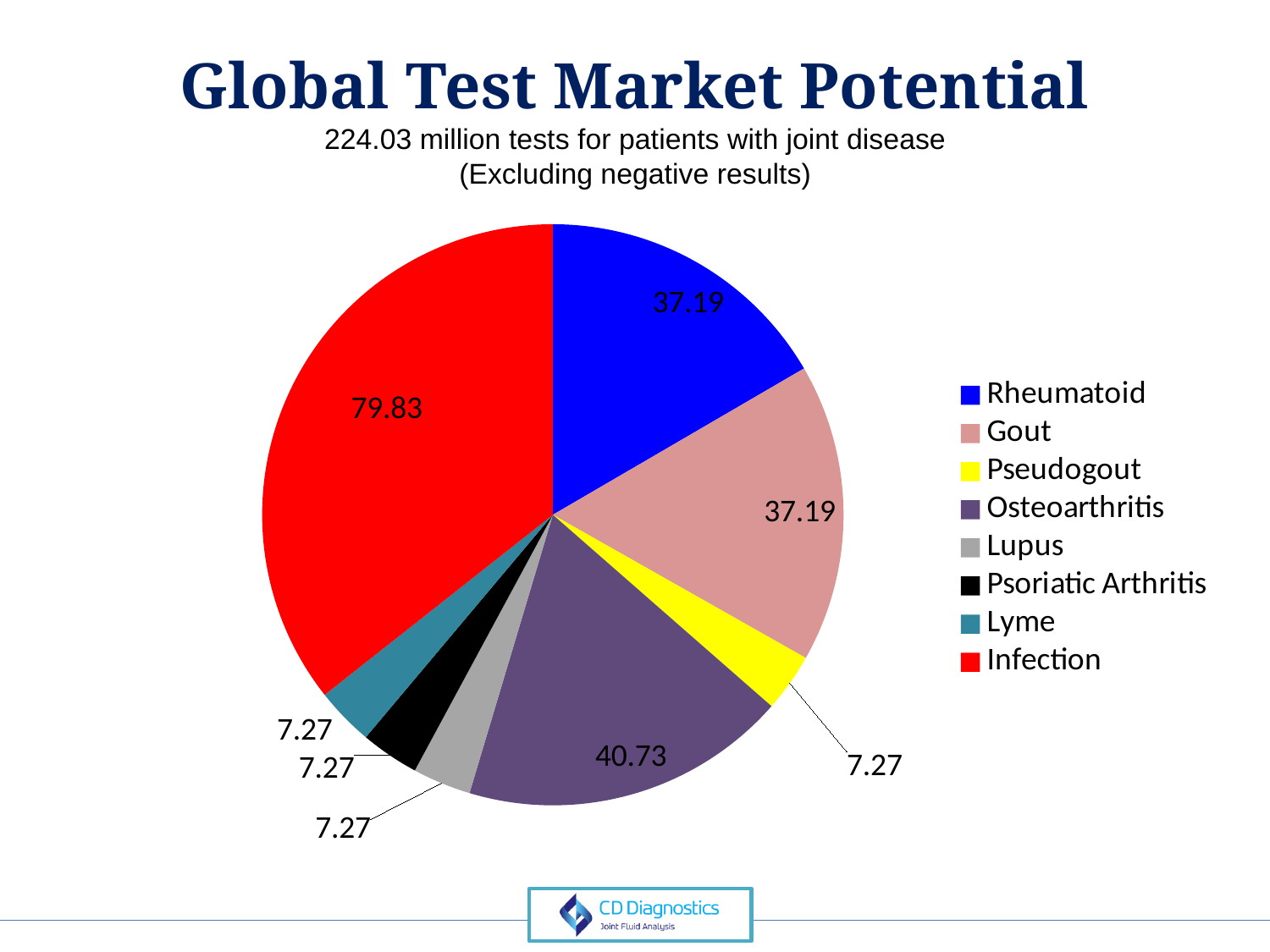
What is the value for Osteoarthritis? 40.73 What colour represents Infection in the pie chart? Red What is the value for Rheumatoid? 37.19 Which category has the largest slice of the pie? Infection How many categories share the value 7.27? 4 How many categories does the legend list? 8 What is the difference between the values for Infection and Osteoarthritis? 39.10 What type of chart is shown on the slide? Pie chart What is the value for Infection? 79.83 What is the value for Lyme? 7.27 Which is larger, the value for Osteoarthritis or the value for Gout? Osteoarthritis What is the title of the slide containing the chart? Global Test Market Potential